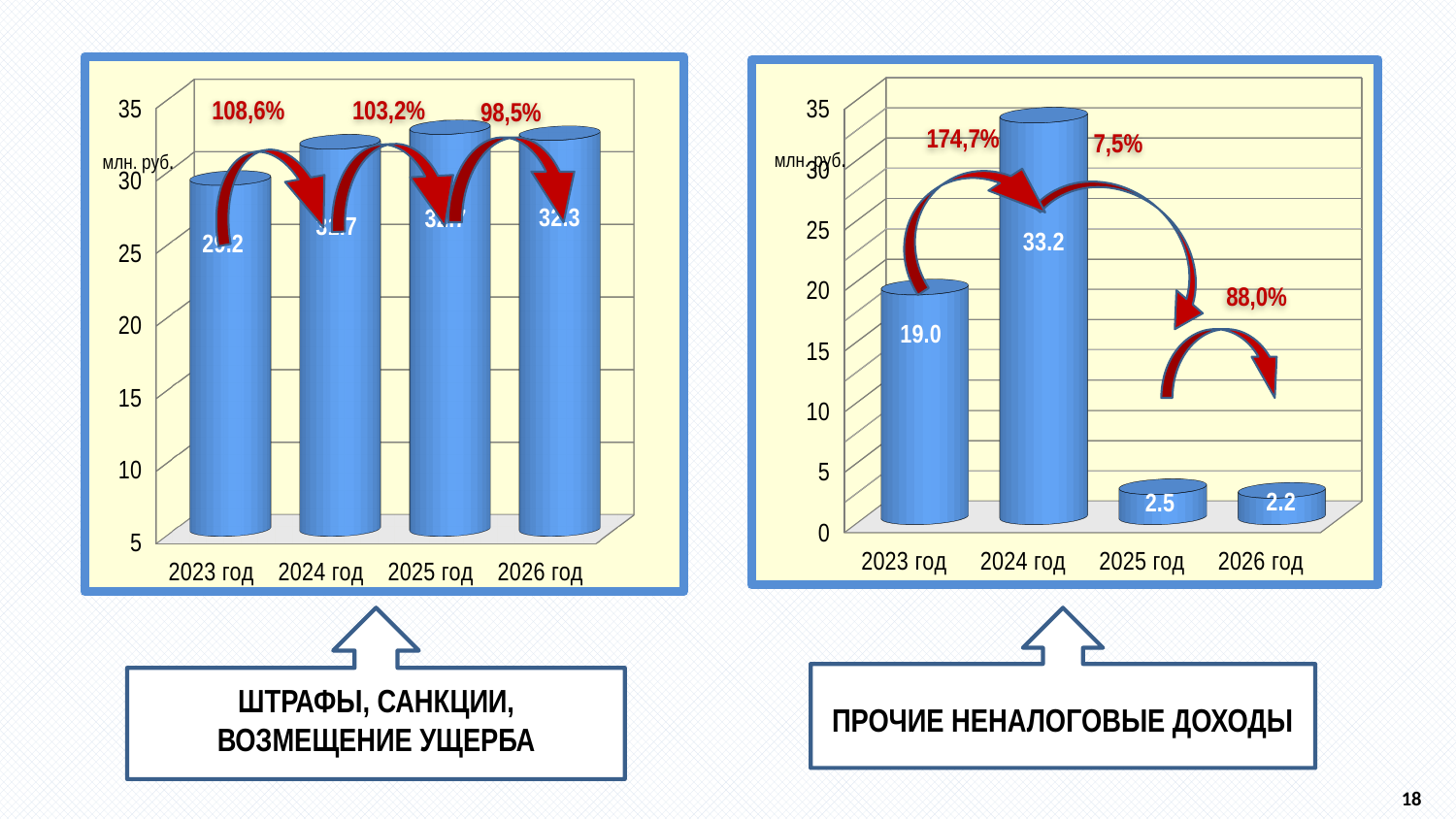
In the chart for ПРОЧИЕ НЕНАЛОГОВЫЕ ДОХОДЫ (right), what is the value for 2023 год? 19.0 What kind of chart is used for ПРОЧИЕ НЕНАЛОГОВЫЕ ДОХОДЫ (right)? bar chart In the chart for ШТРАФЫ, САНКЦИИ, ВОЗМЕЩЕНИЕ УЩЕРБА (left), is the value for 2023 год greater or less than 30? less How many years are shown on the x axis of the chart for ШТРАФЫ, САНКЦИИ, ВОЗМЕЩЕНИЕ УЩЕРБА (left)? 4 In the chart for ПРОЧИЕ НЕНАЛОГОВЫЕ ДОХОДЫ (right), which year has the highest value? 2024 год In the chart for ПРОЧИЕ НЕНАЛОГОВЫЕ ДОХОДЫ (right), which is larger, the value for 2023 год or 2025 год? 2023 год In the chart for ПРОЧИЕ НЕНАЛОГОВЫЕ ДОХОДЫ (right), what is the difference between the values for 2025 год and 2026 год? 0.3 In the chart for ПРОЧИЕ НЕНАЛОГОВЫЕ ДОХОДЫ (right), what is the difference between the values for 2024 год and 2023 год? 14.2 In the chart for ШТРАФЫ, САНКЦИИ, ВОЗМЕЩЕНИЕ УЩЕРБА (left), which year has the lowest value? 2023 год In the chart for ШТРАФЫ, САНКЦИИ, ВОЗМЕЩЕНИЕ УЩЕРБА (left), what is the value for 2026 год? 32.3 In the chart for ПРОЧИЕ НЕНАЛОГОВЫЕ ДОХОДЫ (right), what is the value for 2024 год? 33.2 In the chart for ПРОЧИЕ НЕНАЛОГОВЫЕ ДОХОДЫ (right), what is the value for 2026 год? 2.2